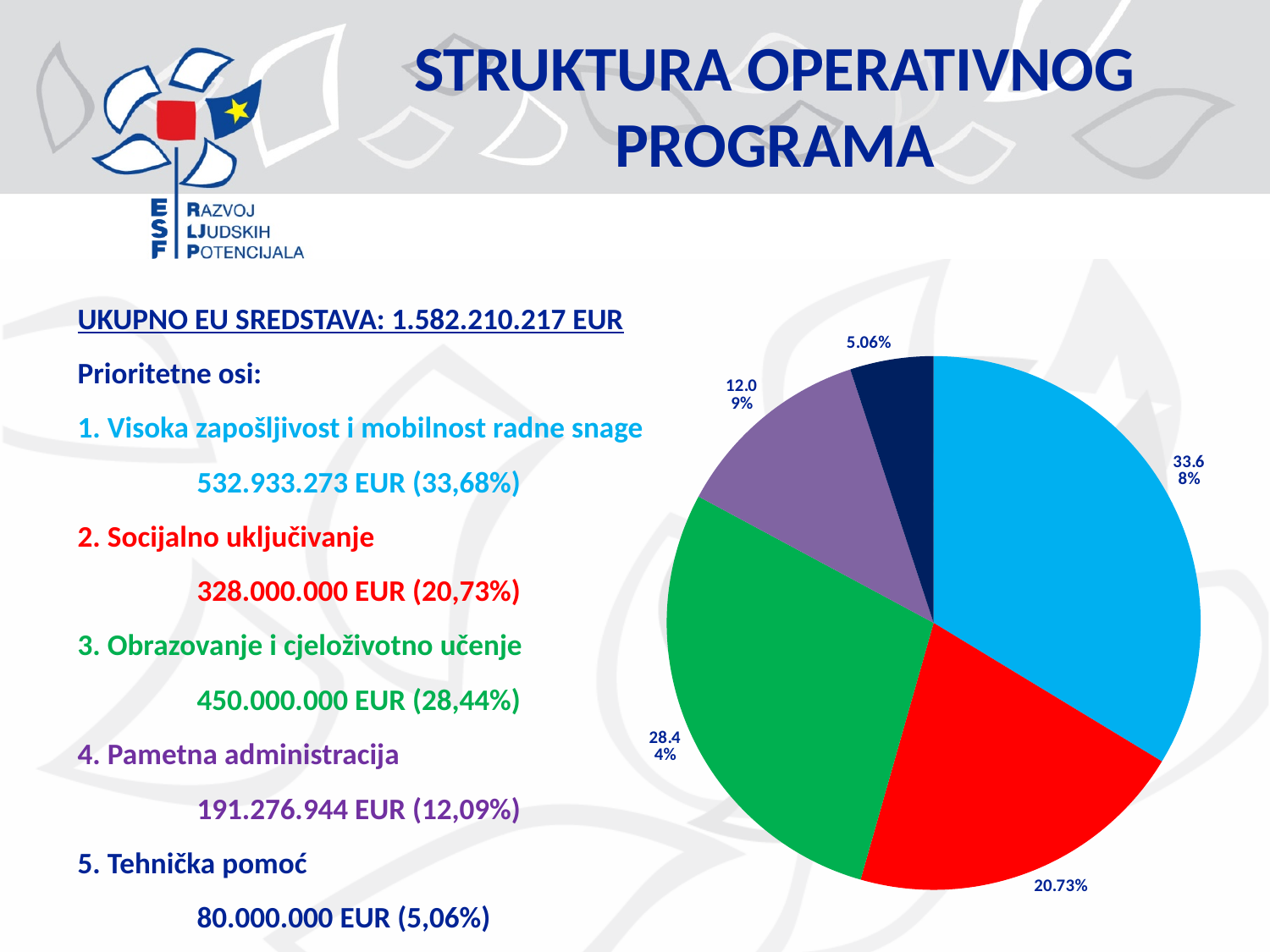
What percentage label is shown on the dark navy slice of the pie chart? 5.06% What percentage label is shown on the green slice of the pie chart? 28.44% What kind of chart is shown on the slide? pie chart Does the pie chart have a legend? No How many slices does the pie chart have? 5 What is the difference in percentage points between the purple slice (12.09%) and the dark navy slice (5.06%)? 7.03 What percentage is shown on the smallest slice of the pie chart? 5.06% What percentage label is shown on the purple slice of the pie chart? 12.09% What percentage label is shown on the red slice of the pie chart? 20.73% What percentage is shown on the largest slice of the pie chart? 33.68% Which slice is larger in the pie chart, the green slice or the red slice? the green slice What is the difference in percentage points between the light blue slice (33.68%) and the red slice (20.73%)? 12.95